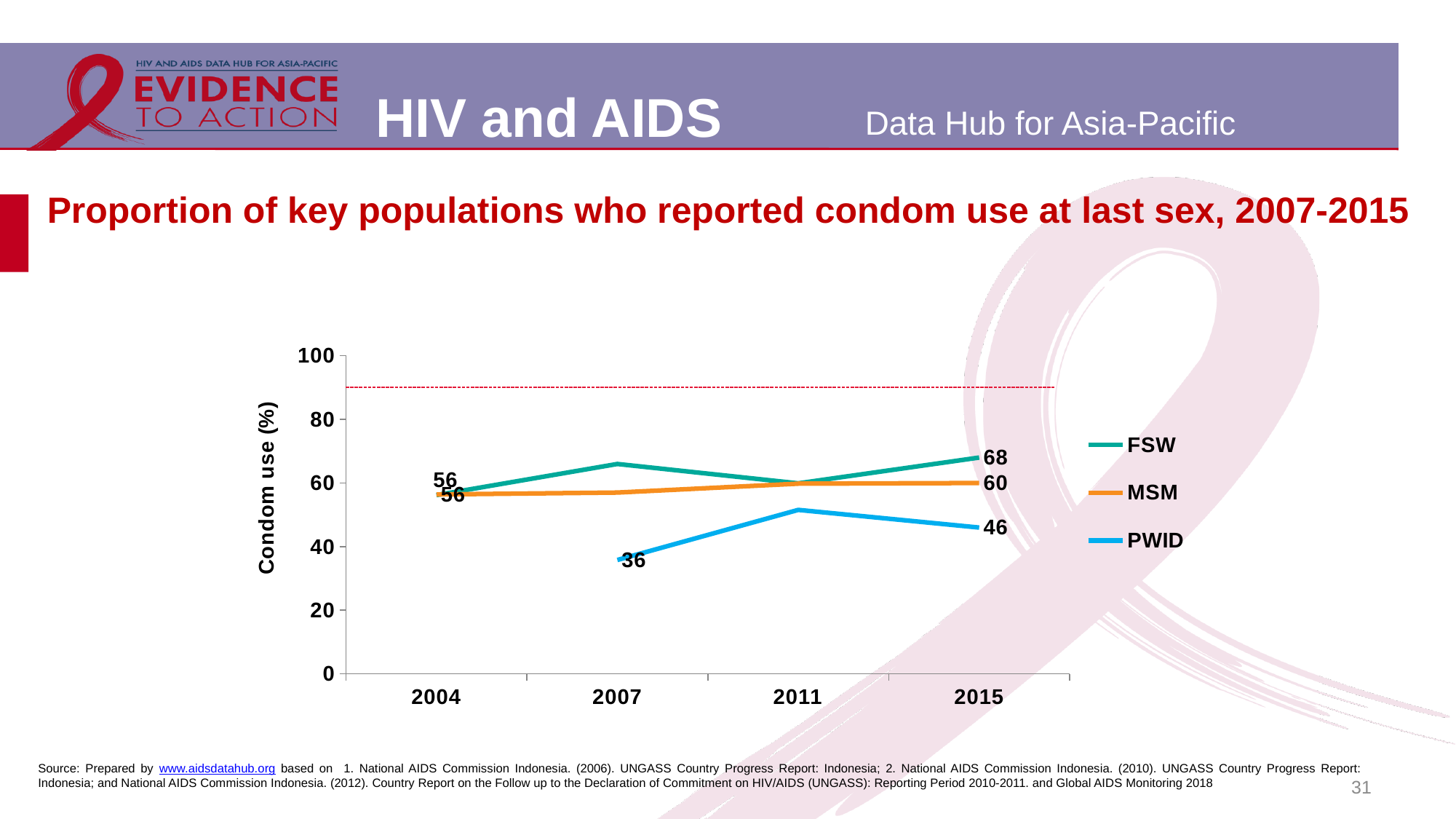
By how much did the PWID value change from 2007 to 2015? 10 What is the value for PWID in 2007? 36 What kind of chart is shown on the slide? line chart Which series has the highest value in 2015? FSW What is the difference between the FSW and MSM values in 2015? 8 What is the value for PWID in 2015? 46 What is the value for MSM in 2015? 60 Is the value for FSW in 2007 greater or less than 60? greater How many series does the legend list? 3 What is the value for FSW in 2015? 68 How many years are shown on the x axis? 4 Is the value for PWID in 2011 greater or less than 60? less